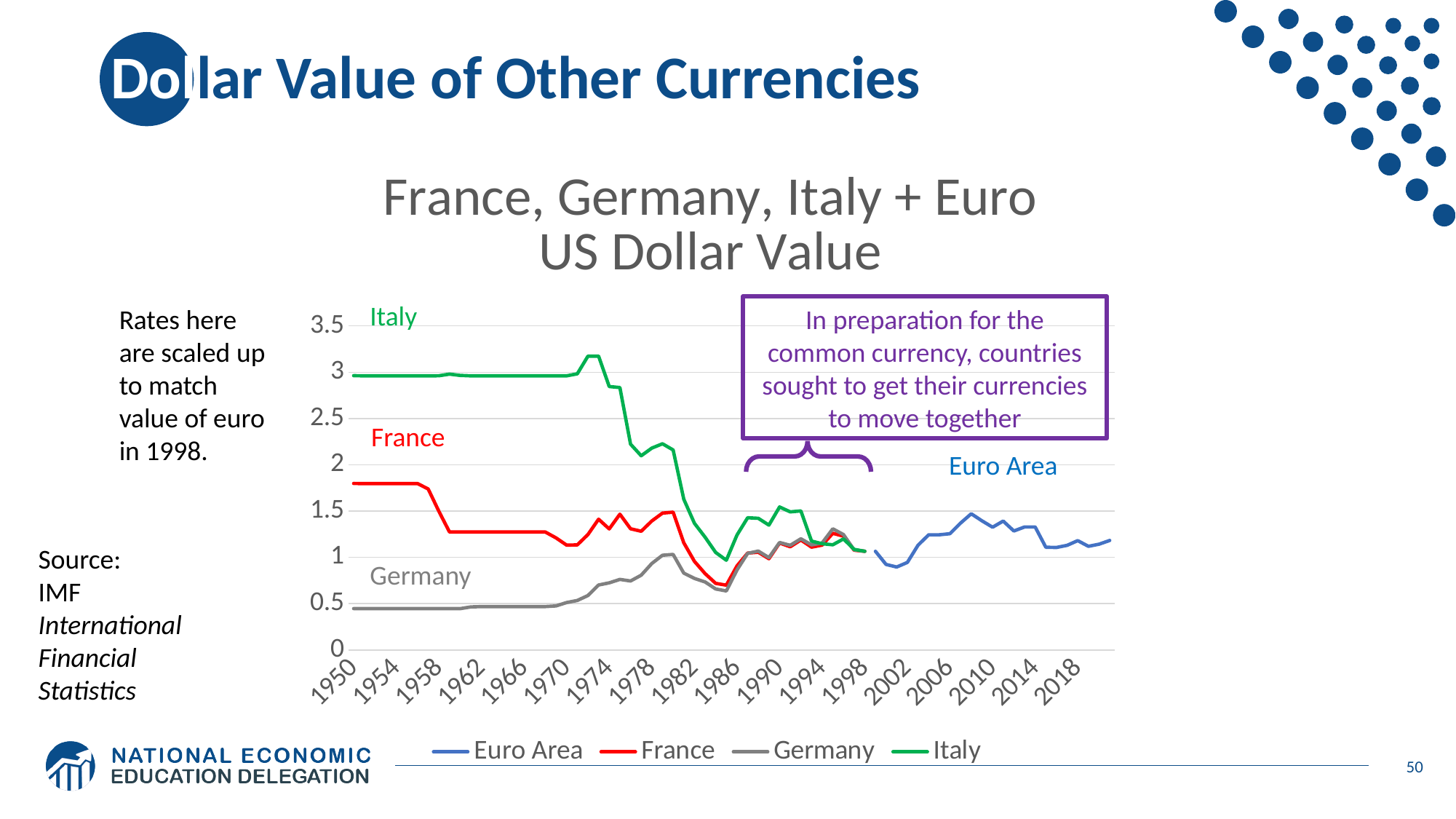
Is the value for Germany in 1950 greater or less than 1? less Does the Italy line rise or fall overall between 1950 and 1998? fall Is the value for Euro Area in 2002 greater or less than 1? less What kind of chart is shown on the slide? line chart Is the value for France in 1950 greater or less than 1.5? greater Which series has the highest value in 1950? Italy How many series does the chart legend list? 4 In 1950, which is higher, France or Germany? France What is the title of the chart? France, Germany, Italy + Euro US Dollar Value Which series is the only one plotted after 1998? Euro Area Which series has the lowest value in 1950? Germany